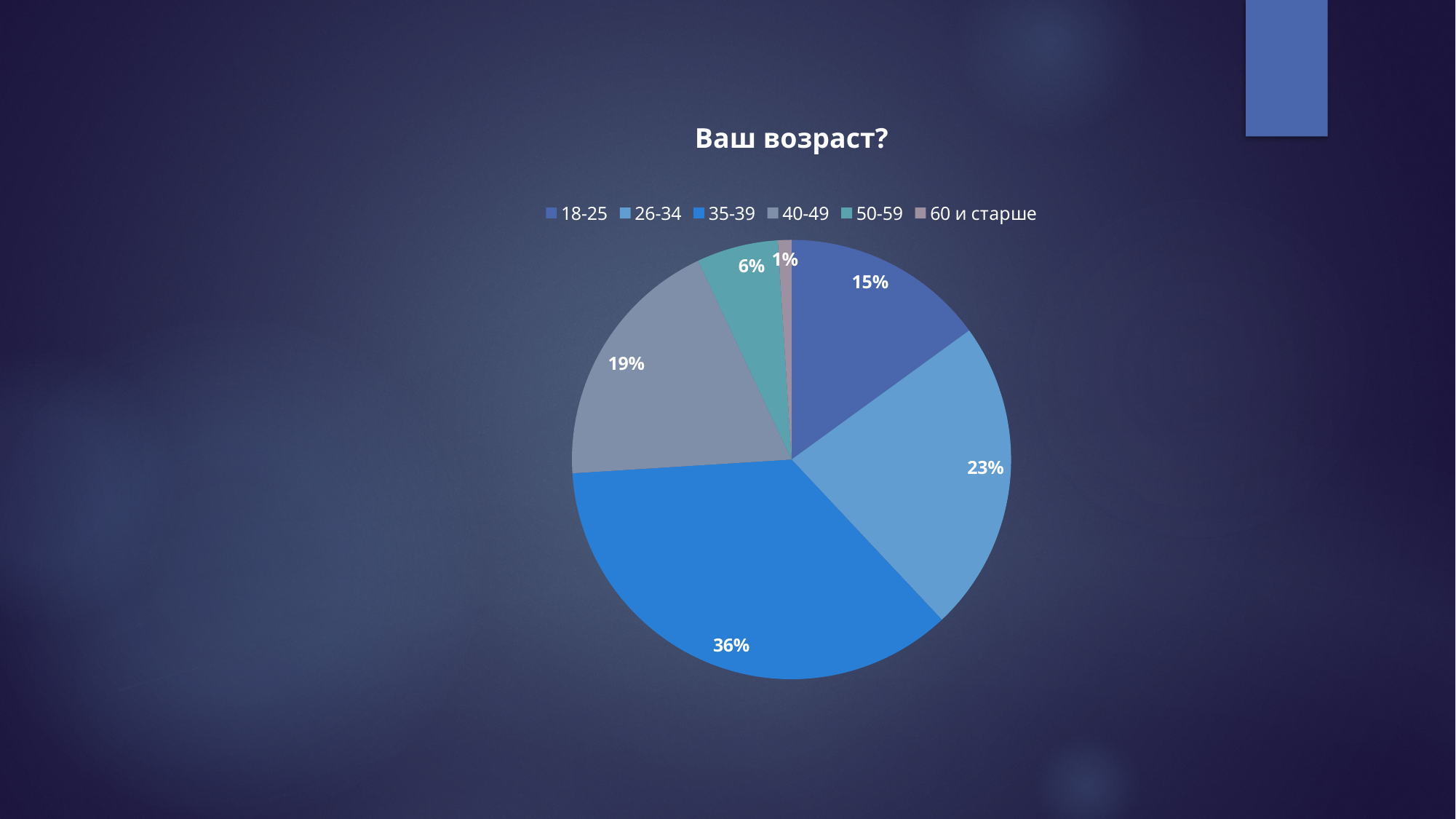
What is the title of the chart? Ваш возраст? What share of the pie does the 35-39 age group have? 36% What type of chart is shown on the slide? pie chart What is the value for the 40-49 age group? 19% Which is larger, the share for 40-49 or the share for 18-25? 40-49 Which age group has the smallest share of the pie? 60 и старше Which age group has the largest share of the pie? 35-39 How many age categories does the legend list? 6 What share of the pie does the 26-34 age group have? 23% What is the value for the 50-59 age group? 6% What is the value for the 18-25 age group? 15% What is the difference between the shares of the 35-39 and 26-34 age groups? 13%